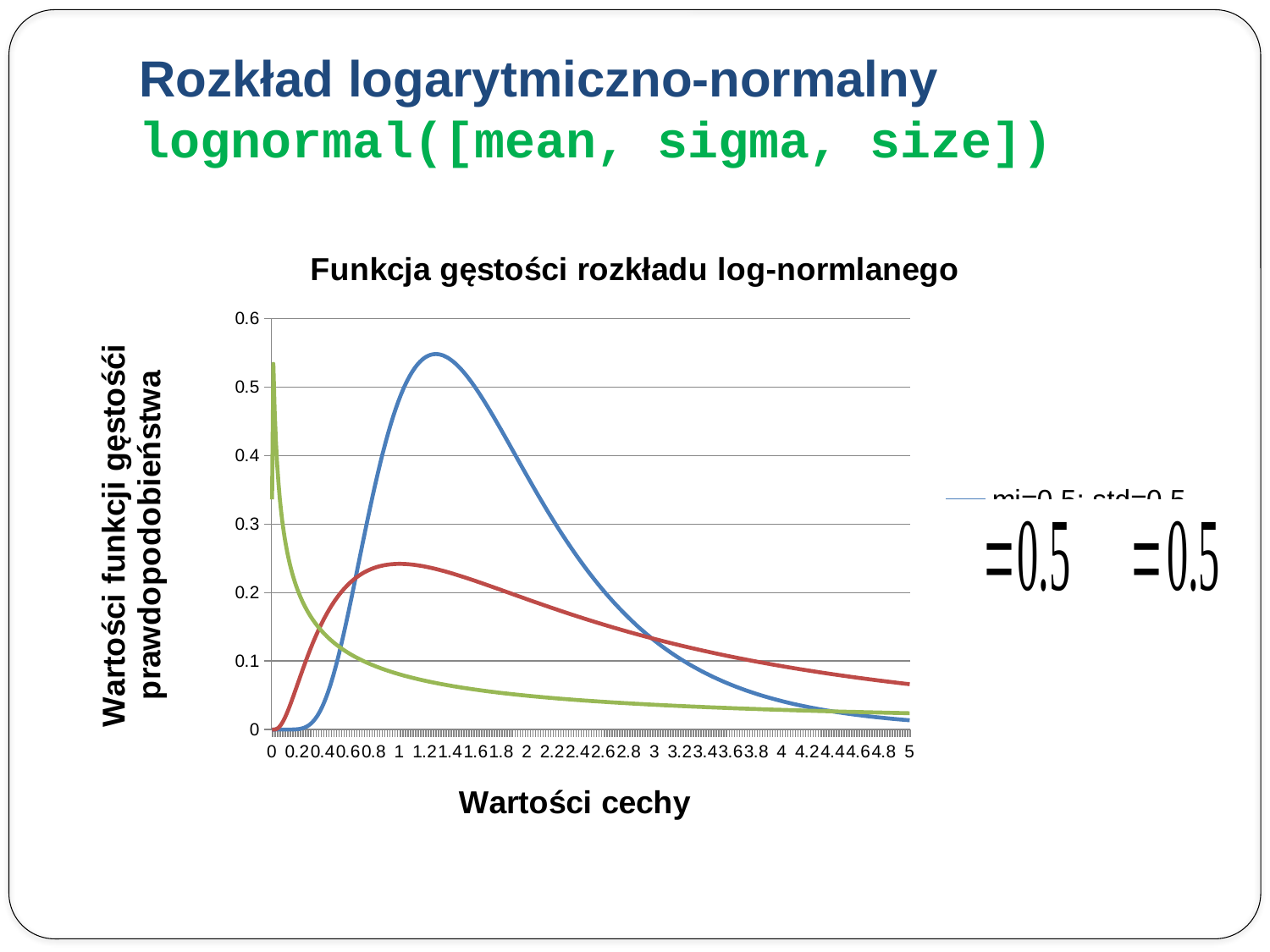
What is the title of the chart? Funkcja gęstości rozkładu log-normlanego How many curves are plotted on the chart? 3 Is the peak value of the blue curve greater or less than 0.5? greater Is the value of the red curve at x = 5 greater or less than 0.1? less Which curve has the highest value at x = 5? the red curve What is the x-axis title of the chart? Wartości cechy Which curve has the highest value at x = 0.2? the green curve Is the peak value of the red curve greater or less than 0.3? less What kind of chart is shown on the slide? line chart Which curve reaches the highest peak value on the chart? the blue curve Does the blue curve rise or fall between x = 2 and x = 5? fall